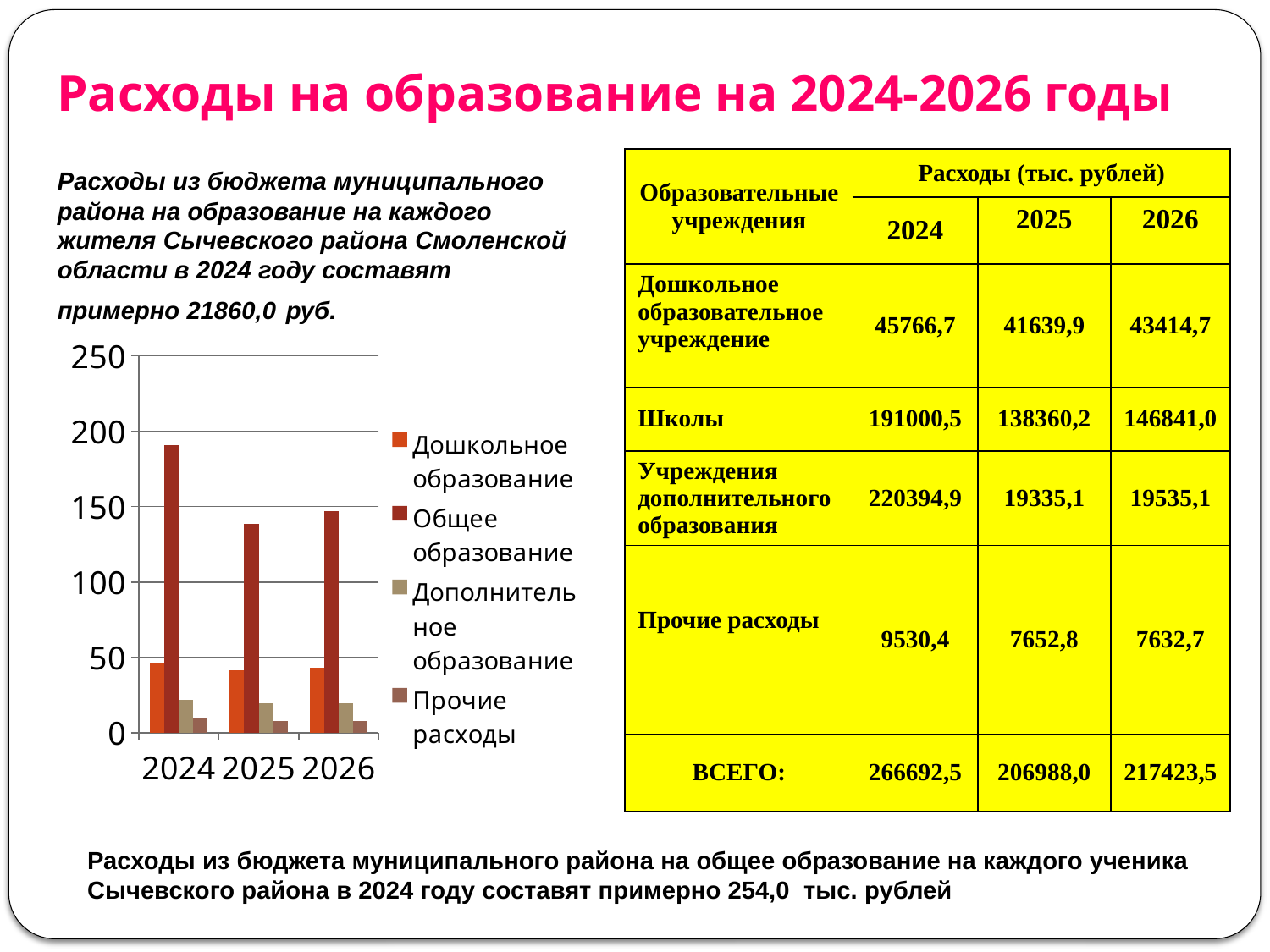
How many years are shown on the x axis of the chart? 3 Is the value for Прочие расходы in 2024 greater or less than 50? less Which series has the smallest bar in 2024? Прочие расходы Is the value for Общее образование in 2024 greater or less than 150? greater How many series does the chart legend list? 4 In which year is the bar for Общее образование the lowest? 2025 Which is larger: Общее образование in 2025 or in 2026? 2026 Is the value for Дошкольное образование in 2024 greater or less than 100? less What kind of chart is shown on the slide? bar chart Does the value for Общее образование rise or fall from 2024 to 2025? fall In which year is the bar for Общее образование the highest? 2024